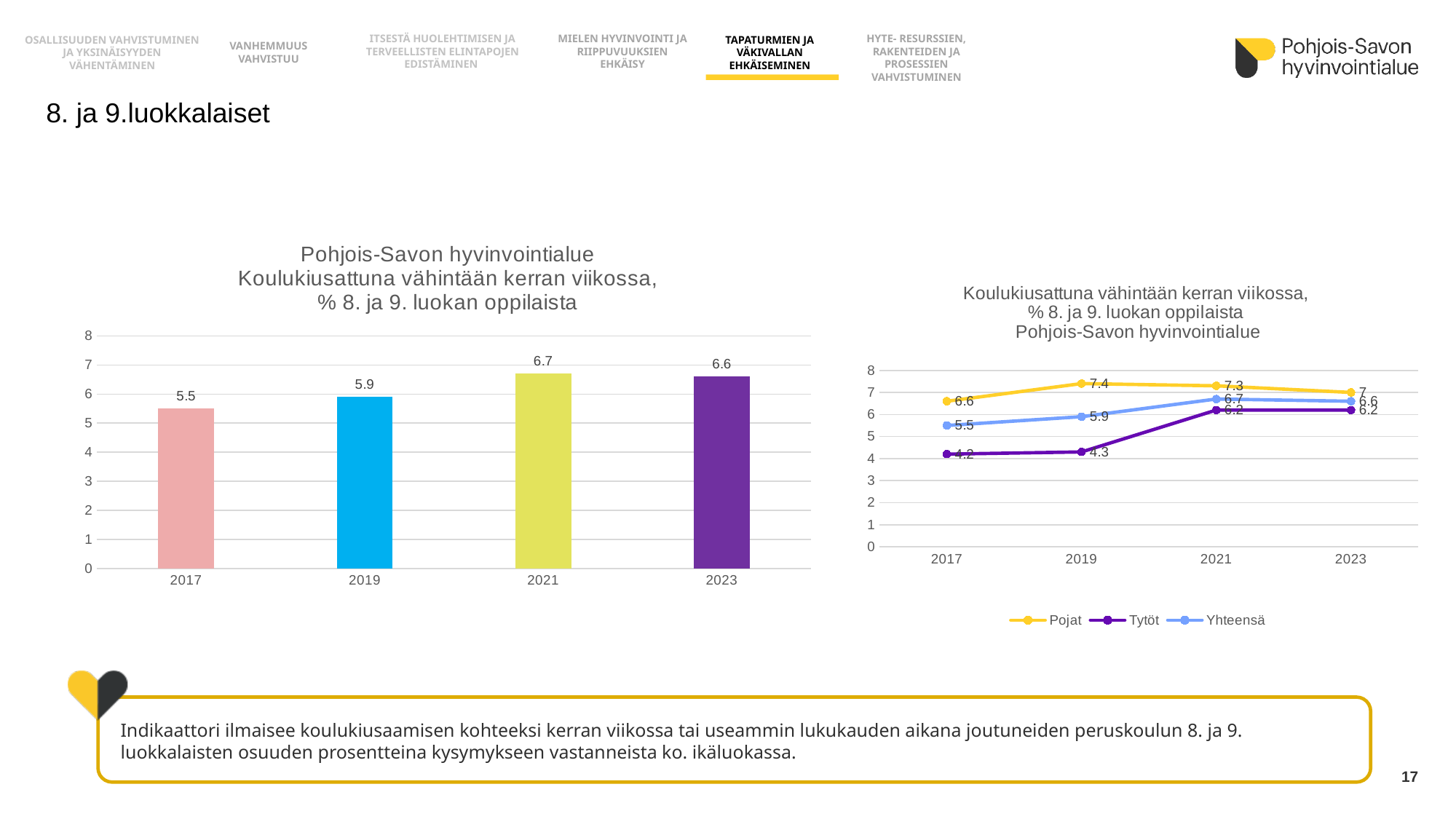
In the line chart on the right, does the Tytöt series rise or fall from 2017 to 2021? rise What kind of chart is the chart on the left? bar chart In the bar chart on the left, which year has the lowest value? 2017 In the line chart on the right, what is the value for Pojat in 2019? 7.4 In the line chart on the right, what is the value for Tytöt in 2017? 4.2 In the line chart on the right, which series has the highest value in 2021? Pojat In the bar chart on the left, what is the difference between the values for 2021 and 2017? 1.2 In the line chart on the right, is the value for Tytöt in 2019 greater or less than 5? less In the line chart on the right, what is the difference between Pojat and Tytöt in 2019? 3.1 In the bar chart on the left, what is the value for 2021? 6.7 In the line chart on the right, how many series does the legend list? 3 In the bar chart on the left, how many years are shown on the x axis? 4